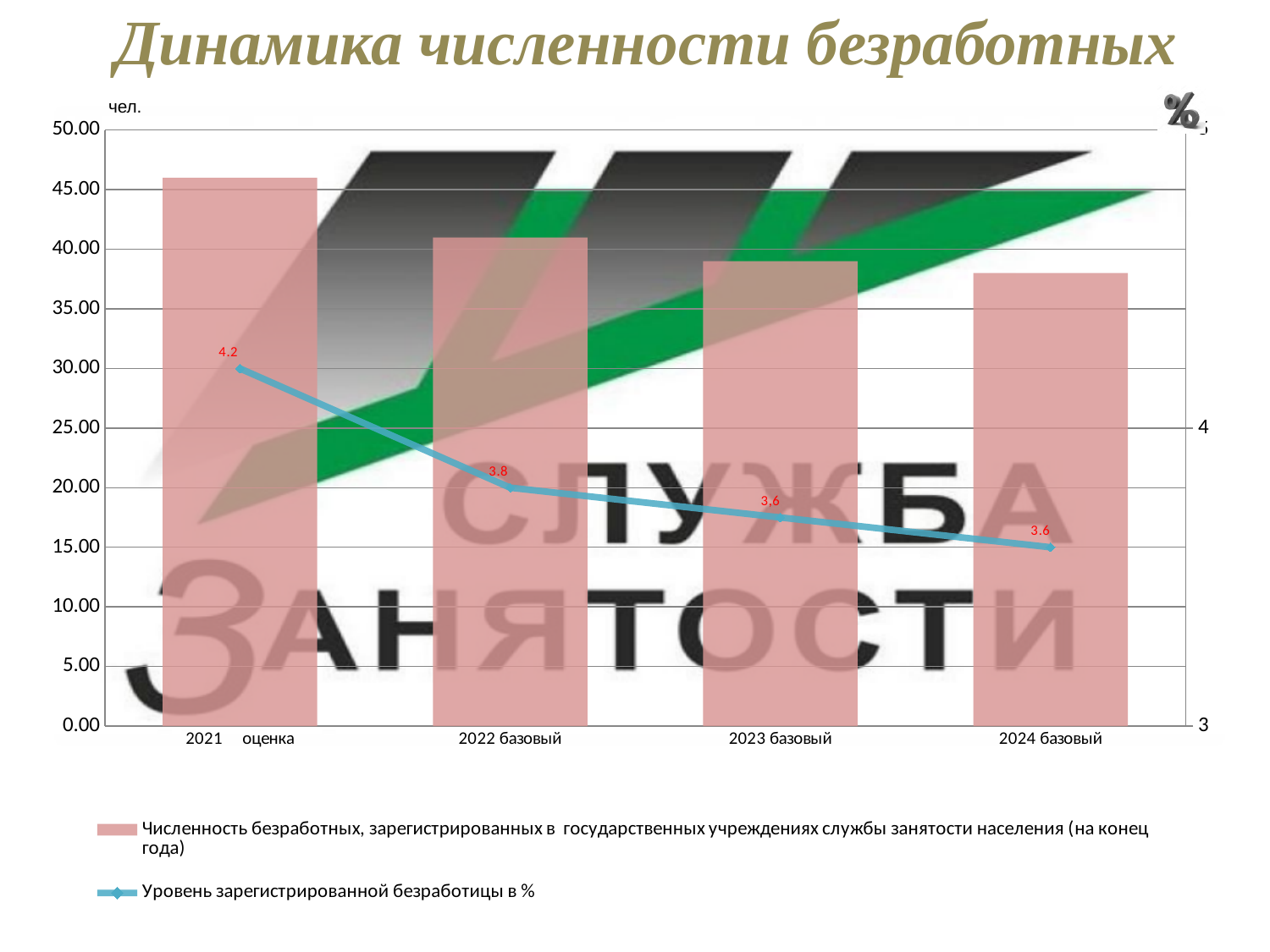
Is the bar value for 2021 оценка greater or less than 40.00? greater What is the value of 'Уровень зарегистрированной безработицы в %' for 2021 оценка? 4.2 In which category is the registered unemployment rate (line series) highest? 2021 оценка Does the unemployment rate line rise or fall from 2021 to 2024? fall Which category has the tallest bar for the number of registered unemployed? 2021 оценка Which is larger, the unemployment rate for 2022 базовый or for 2023 базовый? 2022 базовый What is the value of 'Уровень зарегистрированной безработицы в %' for 2024 базовый? 3.6 How many categories are shown on the x axis? 4 What is the difference between the unemployment rate for 2021 оценка and 2022 базовый? 0.4 How many series does the legend list? 2 What is the value of 'Уровень зарегистрированной безработицы в %' for 2022 базовый? 3.8 Is the bar value for 2024 базовый greater or less than 40.00? less